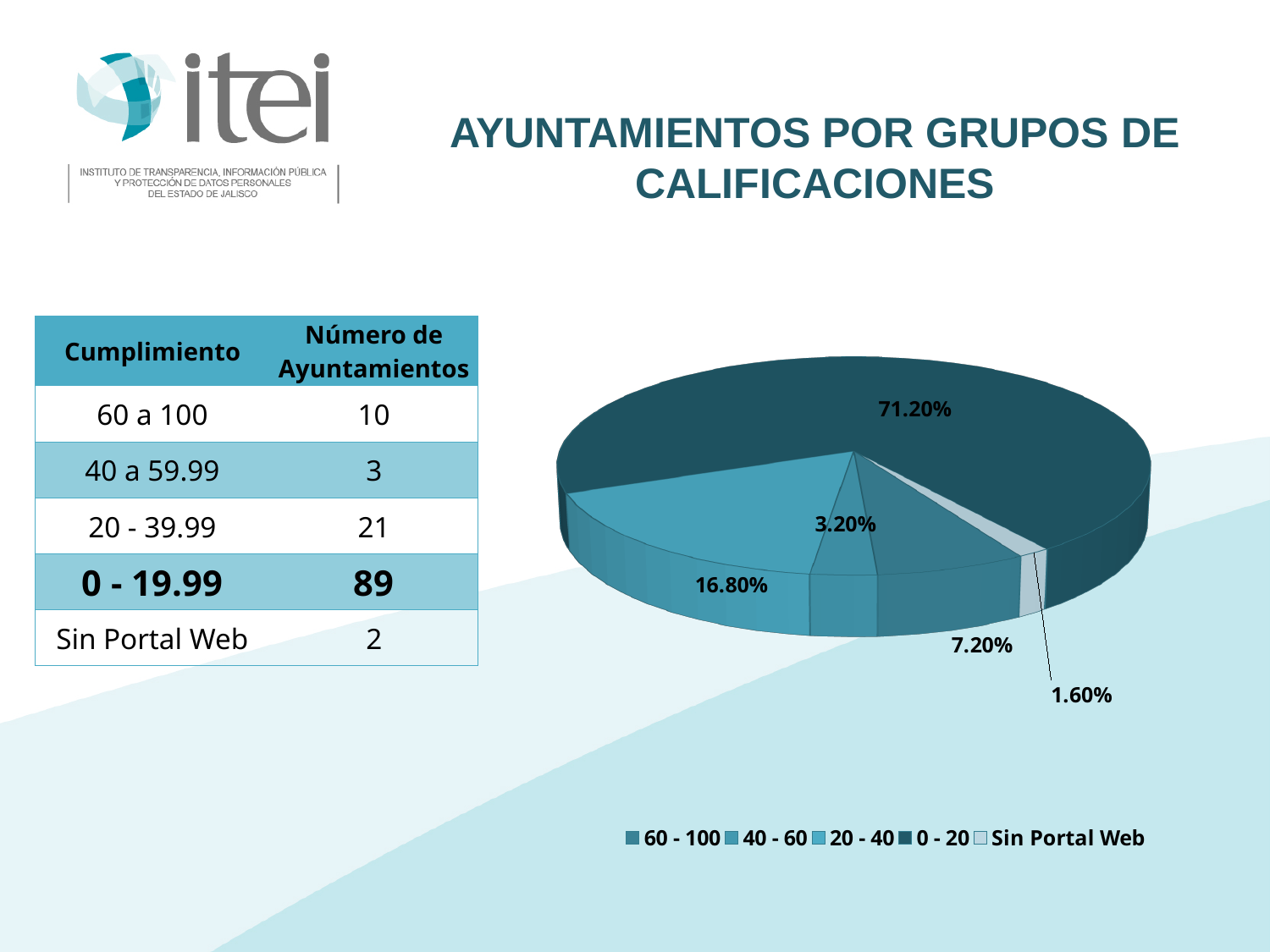
What share of the pie chart does the Sin Portal Web group represent? 1.60% Which group has the smallest slice of the pie chart? Sin Portal Web What share of the pie chart does the 0 - 20 group represent? 71.20% What kind of chart is shown on the slide? pie chart What is the title of the chart on the slide? AYUNTAMIENTOS POR GRUPOS DE CALIFICACIONES How many entries does the legend of the pie chart list? 5 What is the last entry listed in the pie chart's legend? Sin Portal Web Which slice is larger, the one labelled 7.20% or the one labelled 3.20%? 7.20% What share of the pie chart does the 20 - 40 group represent? 16.80% How many slices does the pie chart have? 5 What is the difference in percentage points between the 0 - 20 slice and the 20 - 40 slice? 54.40% Which group has the largest slice of the pie chart? 0 - 20